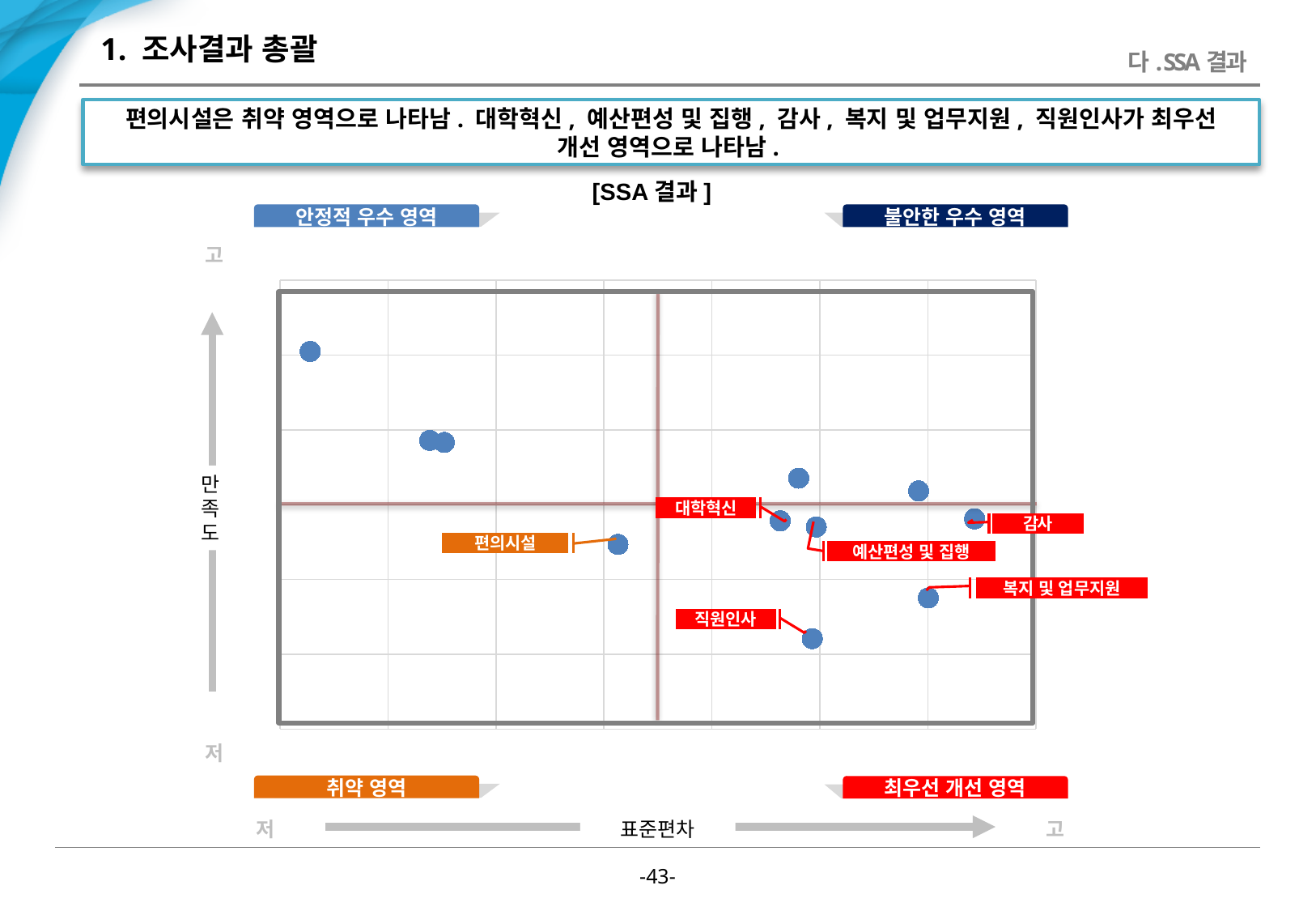
How many data points are plotted in the SSA 결과 chart? 11 What is the label of the horizontal axis of the chart? 표준편차 What is the label of the vertical axis of the chart? 만족도 Which labeled item is furthest to the left (lowest 표준편차) in the chart? 편의시설 Which labeled item has the highest 표준편차 (standard deviation), i.e. is furthest to the right? 감사 Which has the higher 만족도, 대학혁신 or 복지 및 업무지원? 대학혁신 How many data points in the chart have a name label attached? 6 Which labeled item falls in the 취약 영역 (lower-left quadrant) of the chart? 편의시설 Which labeled item has the lowest 만족도 (satisfaction) in the chart? 직원인사 Which has the larger 표준편차, 편의시설 or 복지 및 업무지원? 복지 및 업무지원 What kind of chart is shown on the slide? scatter chart Which has the higher 만족도, 감사 or 직원인사? 감사